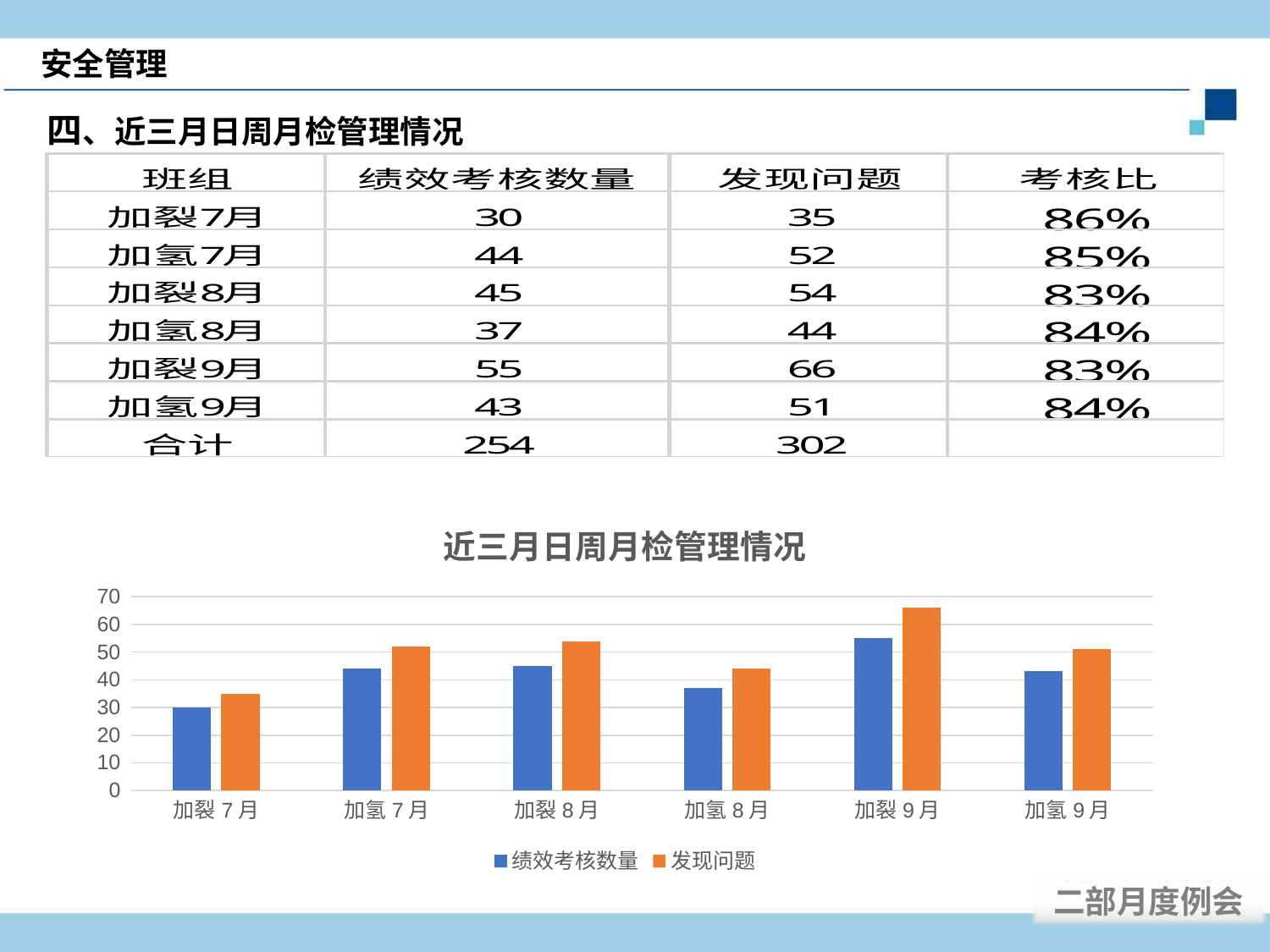
Is the 发现问题 value for 加裂9月 greater or less than 60? greater What is the title of the chart? 近三月日周月检管理情况 How many series does the chart legend list? 2 What is the difference between 发现问题 and 绩效考核数量 for 加氢7月? 8 Which category has the highest 发现问题 value? 加裂9月 Is the 绩效考核数量 value for 加氢8月 greater or less than 40? less Which is larger for 加氢8月, 绩效考核数量 or 发现问题? 发现问题 What type of chart is shown on the slide? bar chart Which category has the lowest 绩效考核数量 value? 加裂7月 What is the value of 发现问题 for 加裂9月? 66 How many categories are shown on the x axis of the chart? 6 What is the value of 绩效考核数量 for 加裂7月? 30